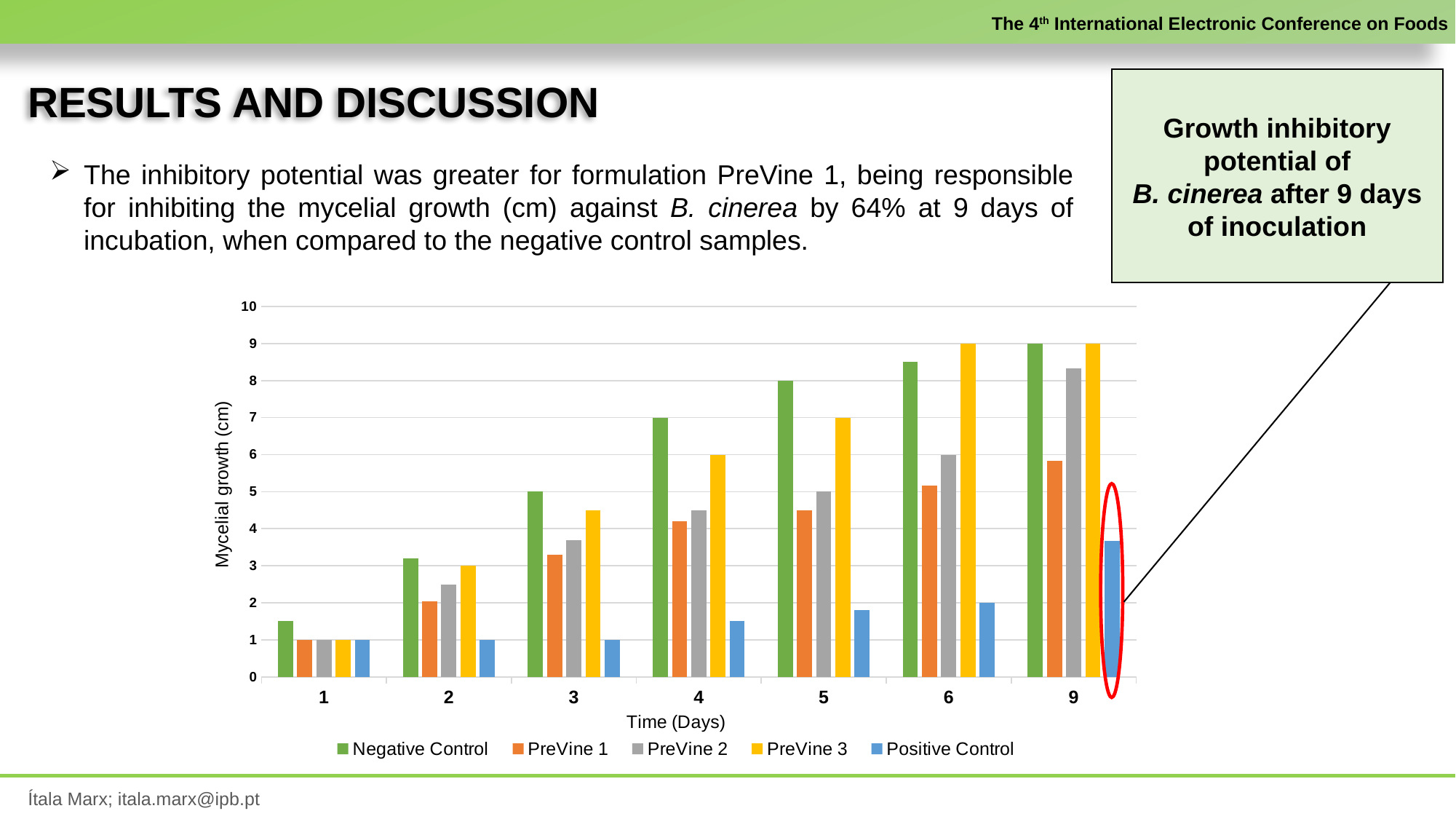
What is the mycelial growth for Negative Control at day 4? 7 What is the mycelial growth for PreVine 3 at day 6? 9 Is the value for Positive Control at day 9 greater or less than 3? greater How many time points (days) are shown on the x axis? 7 At day 9, which is larger: PreVine 1 or PreVine 2? PreVine 2 What is the mycelial growth for Negative Control at day 9? 9 Is the value for PreVine 1 at day 9 greater or less than 5? greater What kind of chart is shown on the slide? bar chart What is the mycelial growth for Positive Control at day 6? 2 How many series does the legend list? 5 Which series has the lowest mycelial growth at day 9? Positive Control What is the difference between Negative Control and PreVine 3 at day 4? 1